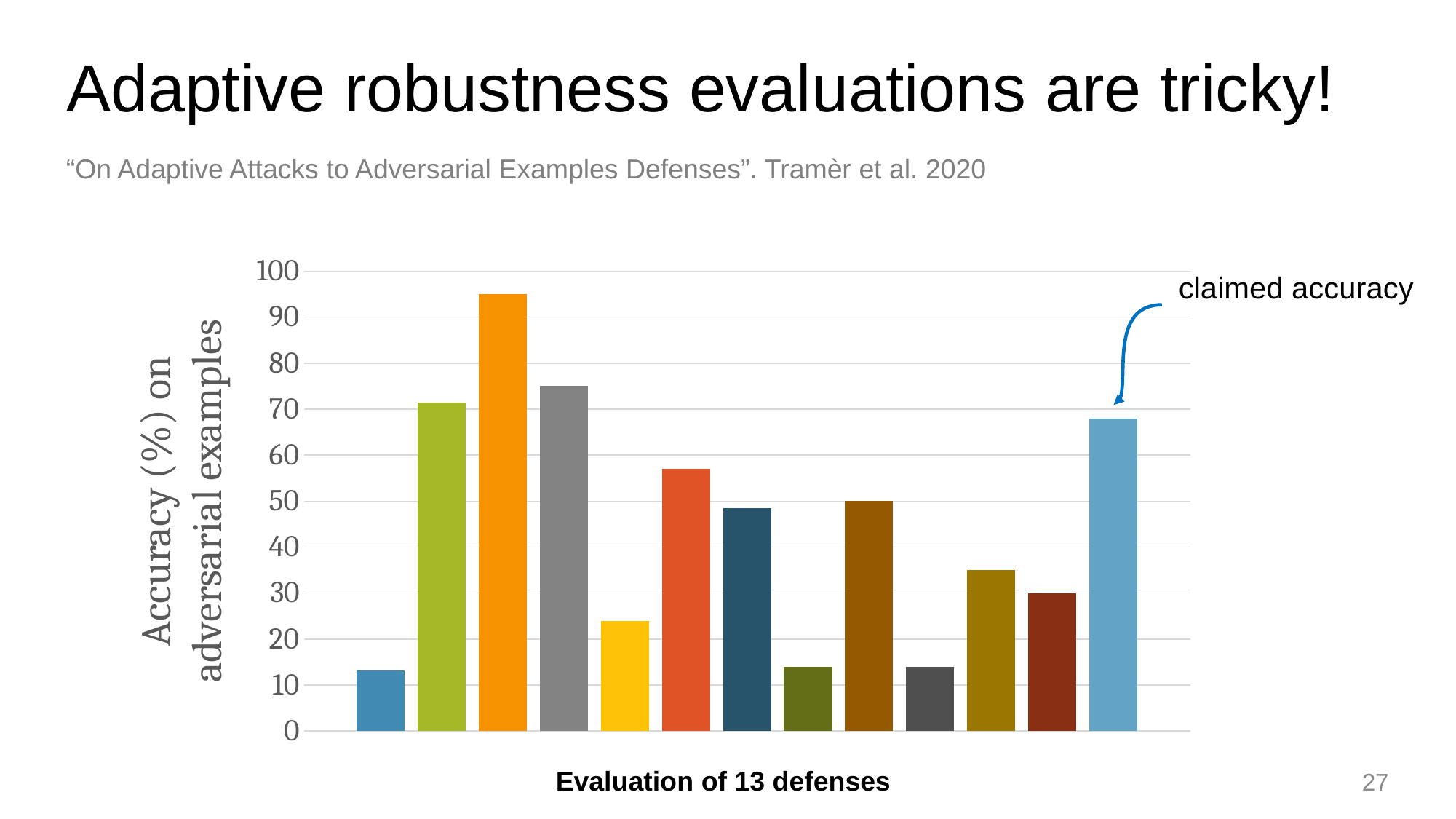
Which is larger: the third bar from the left or the last bar on the right? the third bar from the left What kind of chart is shown on the slide? bar chart Is the value of the third bar from the left greater or less than 90? greater Is the value of the fourth bar from the left greater or less than 70? greater What does the annotation with the arrow pointing to the last bar say? claimed accuracy Which bar is the highest in the chart? the third bar from the left (orange) Is the value of the first bar from the left greater or less than 20? less How many bars (defenses) are plotted in the chart? 13 What is the label of the y axis? Accuracy (%) on adversarial examples Which is larger: the eighth bar from the left or the ninth bar from the left? the ninth bar from the left